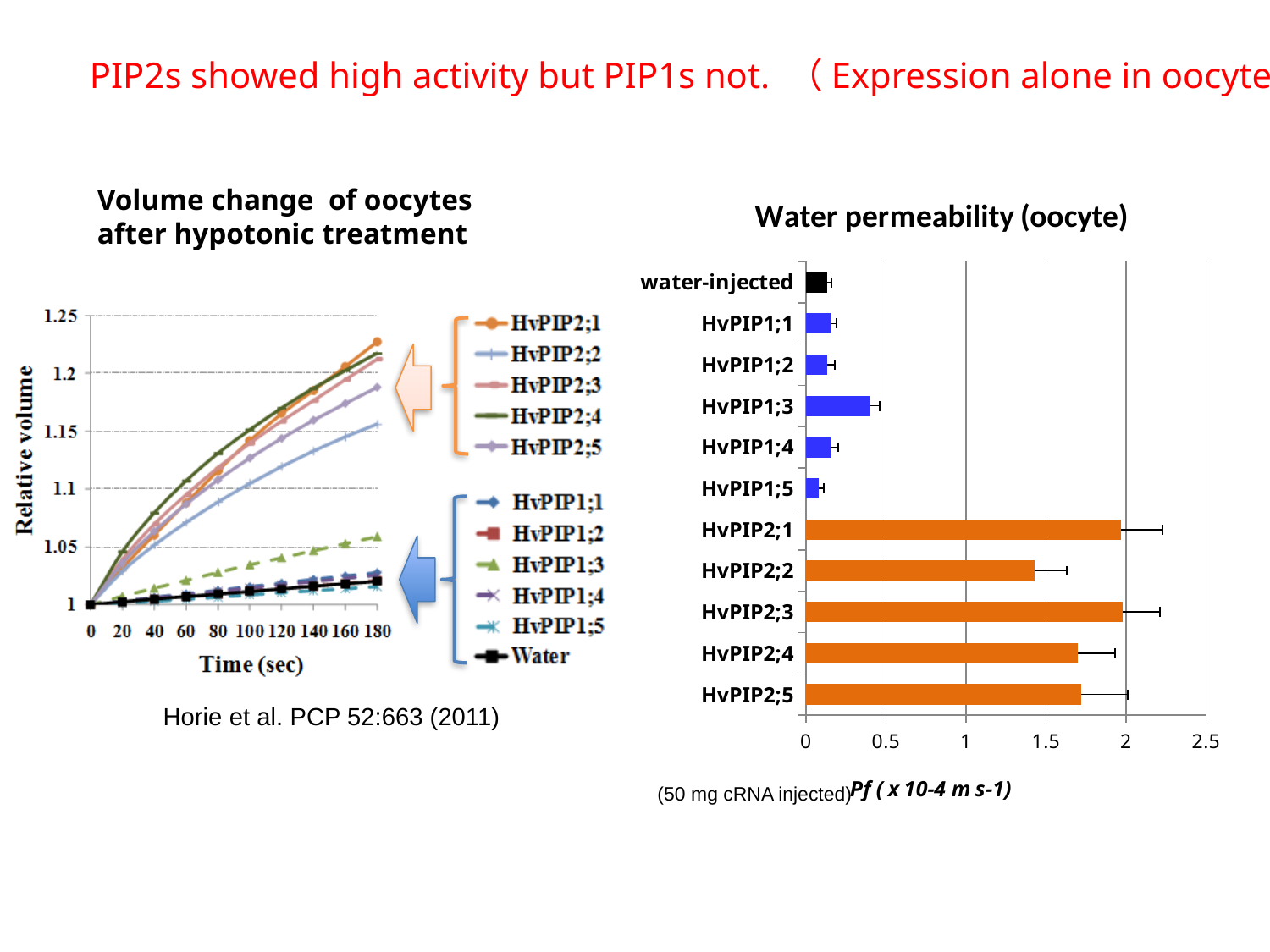
In the "Volume change of oocytes after hypotonic treatment" chart, does the HvPIP2;1 series rise or fall as time increases? rise In the "Water permeability (oocyte)" chart, which has the larger value, HvPIP1;3 or HvPIP1;1? HvPIP1;3 In the "Volume change of oocytes after hypotonic treatment" chart, is the value for HvPIP2;2 at 180 sec greater or less than 1.2? less What is the x-axis label of the "Volume change of oocytes after hypotonic treatment" chart? Time (sec) In the "Volume change of oocytes after hypotonic treatment" chart, how many series does the legend list? 11 In the "Water permeability (oocyte)" chart, is the value for HvPIP2;2 greater or less than 1.5? less What kind of chart is the "Water permeability (oocyte)" chart? bar chart In the "Water permeability (oocyte)" chart, is the value for HvPIP2;1 greater or less than 1.5? greater In the "Water permeability (oocyte)" chart, which has the larger value, HvPIP2;1 or HvPIP2;2? HvPIP2;1 What kind of chart is the "Volume change of oocytes after hypotonic treatment" chart? line chart In the "Water permeability (oocyte)" chart, how many categories are plotted? 11